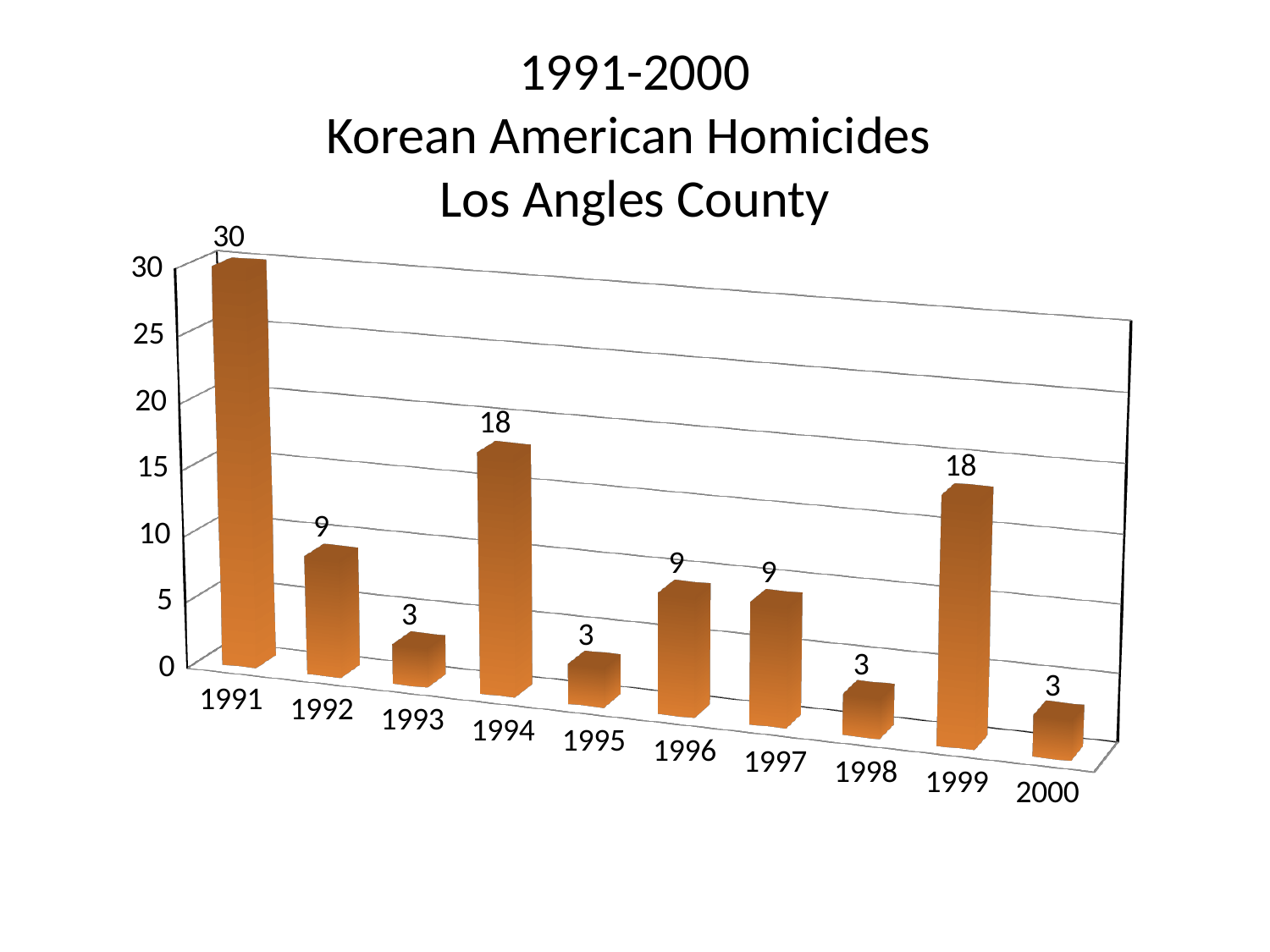
Is the value for 1999 greater or less than 15? greater What is the difference between the values for 1992 and 1993? 6 How many years are shown on the x axis? 10 What is the value for 1997? 9 Which year has the highest value? 1991 What is the title of the chart? 1991-2000 Korean American Homicides Los Angles County What kind of chart is shown on the slide? bar chart What is the value for 1991? 30 What is the difference between the values for 1991 and 1999? 12 What is the value for 1994? 18 What is the value for 2000? 3 Which is larger, the value for 1994 or the value for 1996? 1994